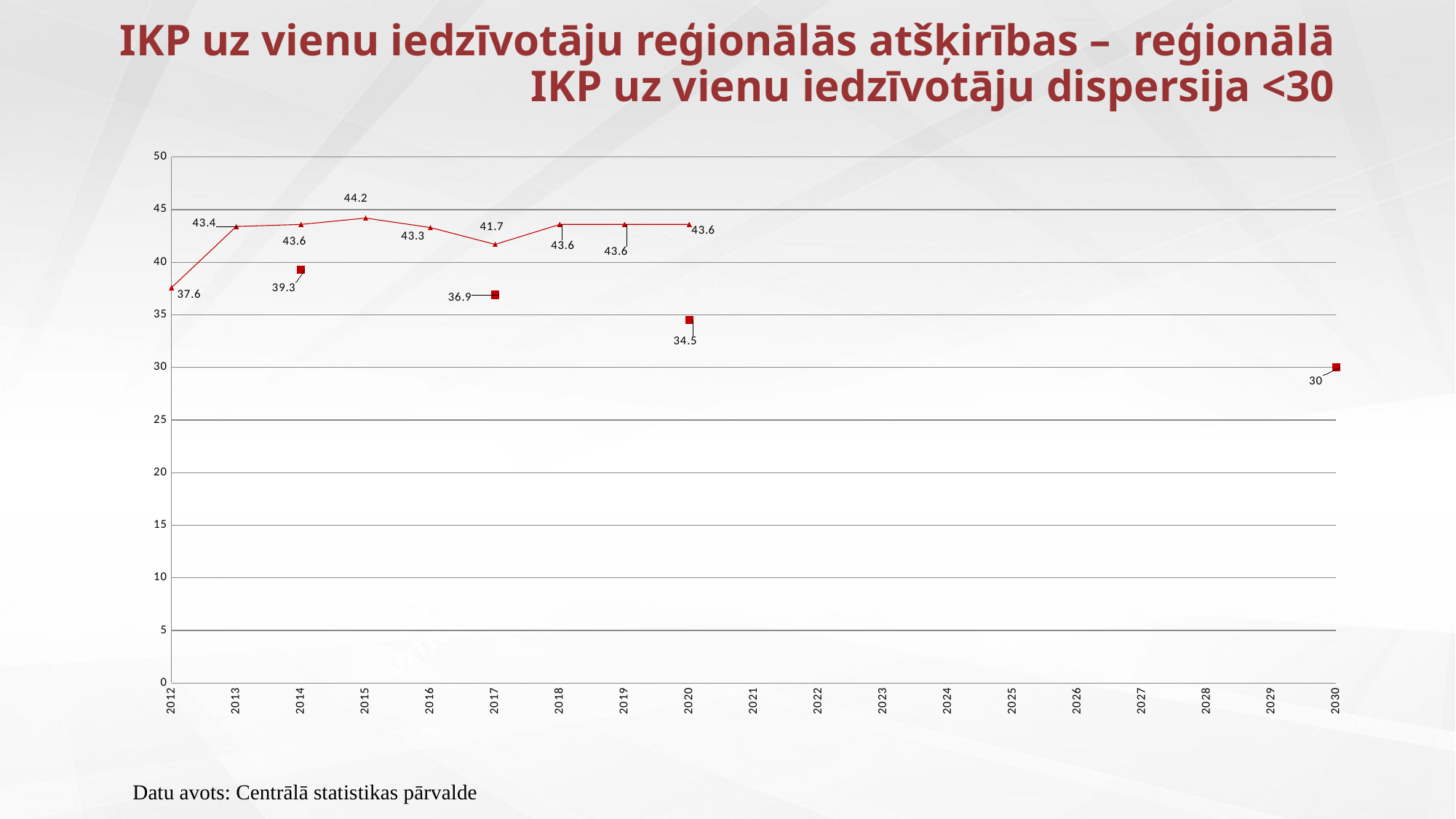
What is the value of the line series in 2015? 44.2 What kind of chart is shown on the slide? line chart Is the square-marker value in 2014 greater or less than 40? less What is the difference between the line value in 2015 and the line value in 2012? 6.6 Which is larger: the line value in 2017 or the square-marker value in 2017? the line value in 2017 What is the value of the square-marker point in 2030? 30 What is the difference between the line value in 2020 and the square-marker value in 2020? 9.1 What is the value of the line series in 2012? 37.6 Do the square-marker values rise or fall from 2014 to 2030? fall In which year does the line series reach its highest value? 2015 In which year does the line series have its lowest value? 2012 What is the value of the square-marker point in 2020? 34.5